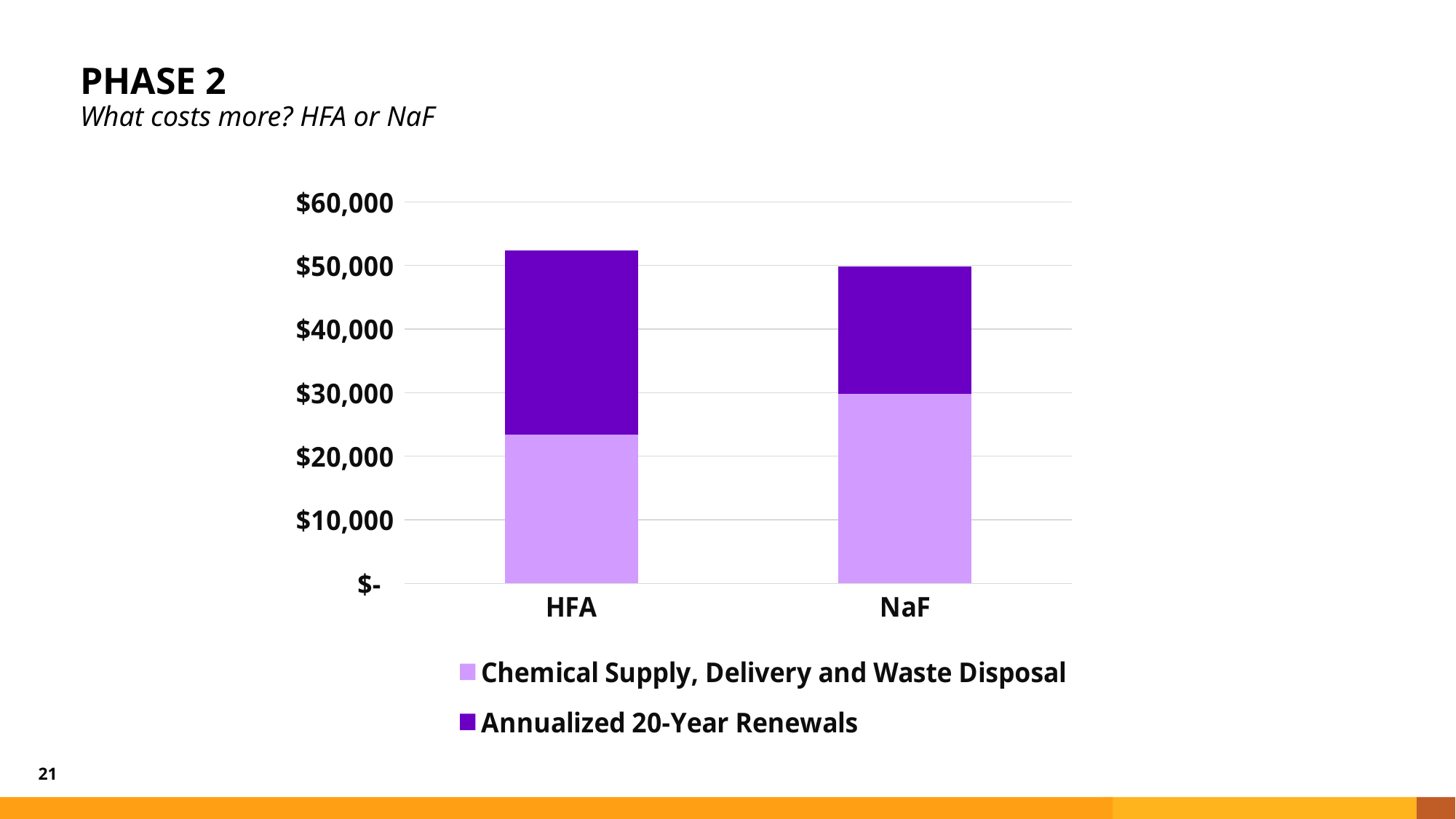
Is the total of the HFA bar greater or less than $50,000? greater Which category has the taller total bar, HFA or NaF? HFA How many series does the legend list? 2 Which category has the larger Annualized 20-Year Renewals segment, HFA or NaF? HFA How many categories are plotted on the x axis? 2 Is the total of the NaF bar greater or less than $60,000? less Which series is shown in the darker purple colour? Annualized 20-Year Renewals What kind of chart is shown on the slide? stacked bar chart Is the Chemical Supply, Delivery and Waste Disposal value for HFA greater or less than $30,000? less Which category has the larger Chemical Supply, Delivery and Waste Disposal segment, HFA or NaF? NaF What is the subtitle question written under the slide title? What costs more? HFA or NaF